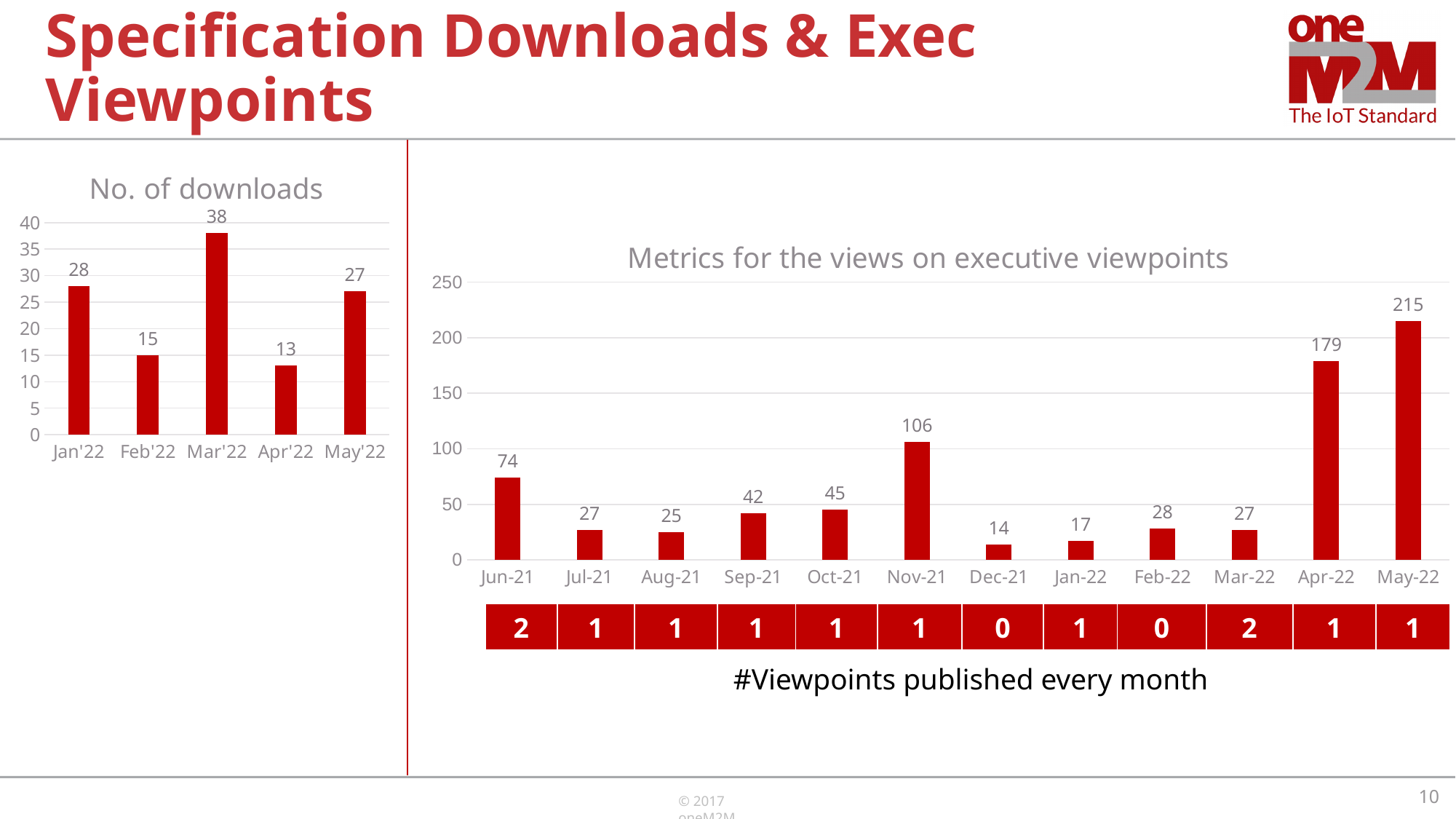
In the 'No. of downloads' chart, what is the value for Mar'22? 38 In the 'No. of downloads' chart, how many months are shown on the x axis? 5 In the 'Metrics for the views on executive viewpoints' chart, what is the value for Nov-21? 106 In the 'No. of downloads' chart, what is the difference between the values for Jan'22 and Feb'22? 13 In the 'Metrics for the views on executive viewpoints' chart, what is the difference between the values for May-22 and Apr-22? 36 In the 'Metrics for the views on executive viewpoints' chart, is the value for Apr-22 greater or less than 150? greater In the 'Metrics for the views on executive viewpoints' chart, which is larger, the value for Jun-21 or the value for Oct-21? Jun-21 In the 'Metrics for the views on executive viewpoints' chart, which month has the highest value? May-22 What kind of chart is the 'No. of downloads' chart? Bar chart In the 'Metrics for the views on executive viewpoints' chart, how many months are shown on the x axis? 12 In the 'Metrics for the views on executive viewpoints' chart, which month has the lowest value? Dec-21 In the 'No. of downloads' chart, which month has the lowest number of downloads? Apr'22